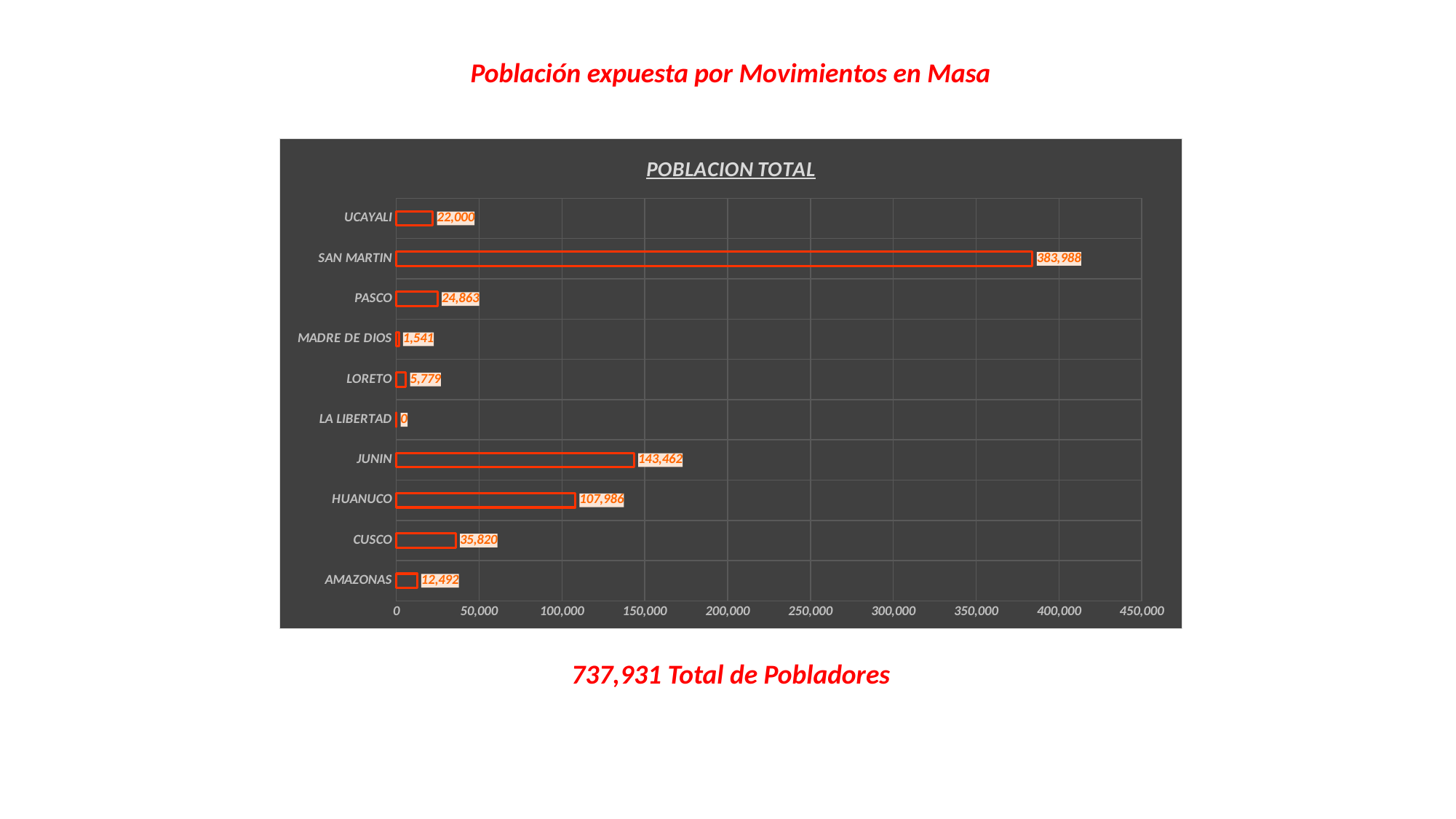
How many categories are shown in the chart? 10 What is the value for HUANUCO? 107,986 Which category has the highest value? SAN MARTIN What is the value for JUNIN? 143,462 Which category has the lowest value? LA LIBERTAD What is the difference between the values for JUNIN and HUANUCO? 35,476 Which is larger, the value for CUSCO or the value for PASCO? CUSCO What is the value for MADRE DE DIOS? 1,541 What is the value for SAN MARTIN? 383,988 Is the value for SAN MARTIN greater or less than 350,000? greater What kind of chart is shown? bar chart What is the title of the chart? POBLACION TOTAL